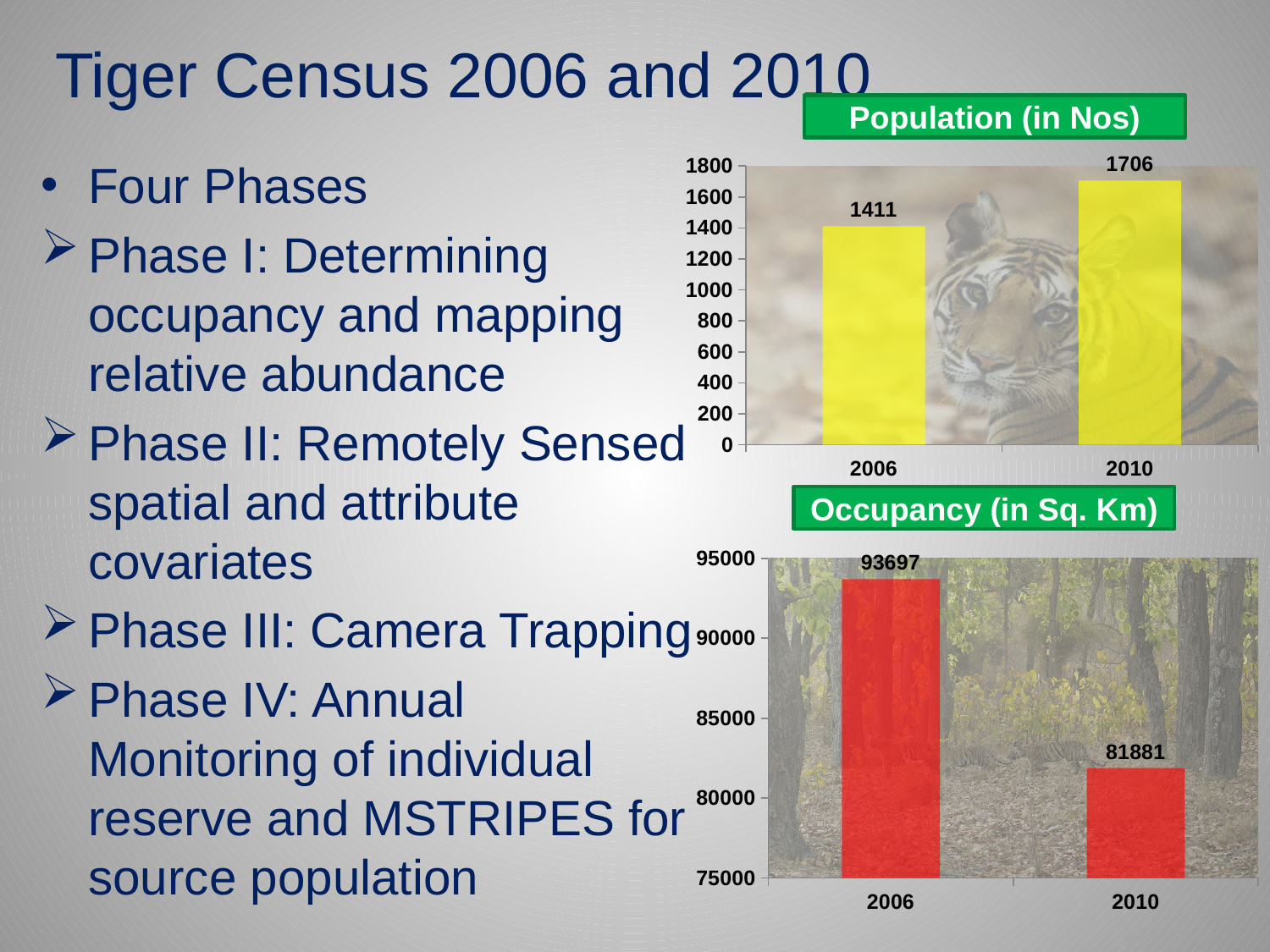
In the Occupancy (in Sq. Km) chart, do the values rise or fall from 2006 to 2010? fall In the Occupancy (in Sq. Km) chart, what is the difference between the 2006 and 2010 values? 11816 In the Occupancy (in Sq. Km) chart, what is the value for 2010? 81881 In the Occupancy (in Sq. Km) chart, which year has the lower value? 2010 What kind of chart is the Population (in Nos) chart? bar chart In the Population (in Nos) chart, what is the difference between the 2010 and 2006 values? 295 How many bars are in the Population (in Nos) chart? 2 In the Population (in Nos) chart, which year has the higher value? 2010 In the Occupancy (in Sq. Km) chart, what is the value for 2006? 93697 In the Population (in Nos) chart, what is the value for 2010? 1706 In the Occupancy (in Sq. Km) chart, is the value for 2006 greater or less than 90000? greater In the Population (in Nos) chart, what is the value for 2006? 1411